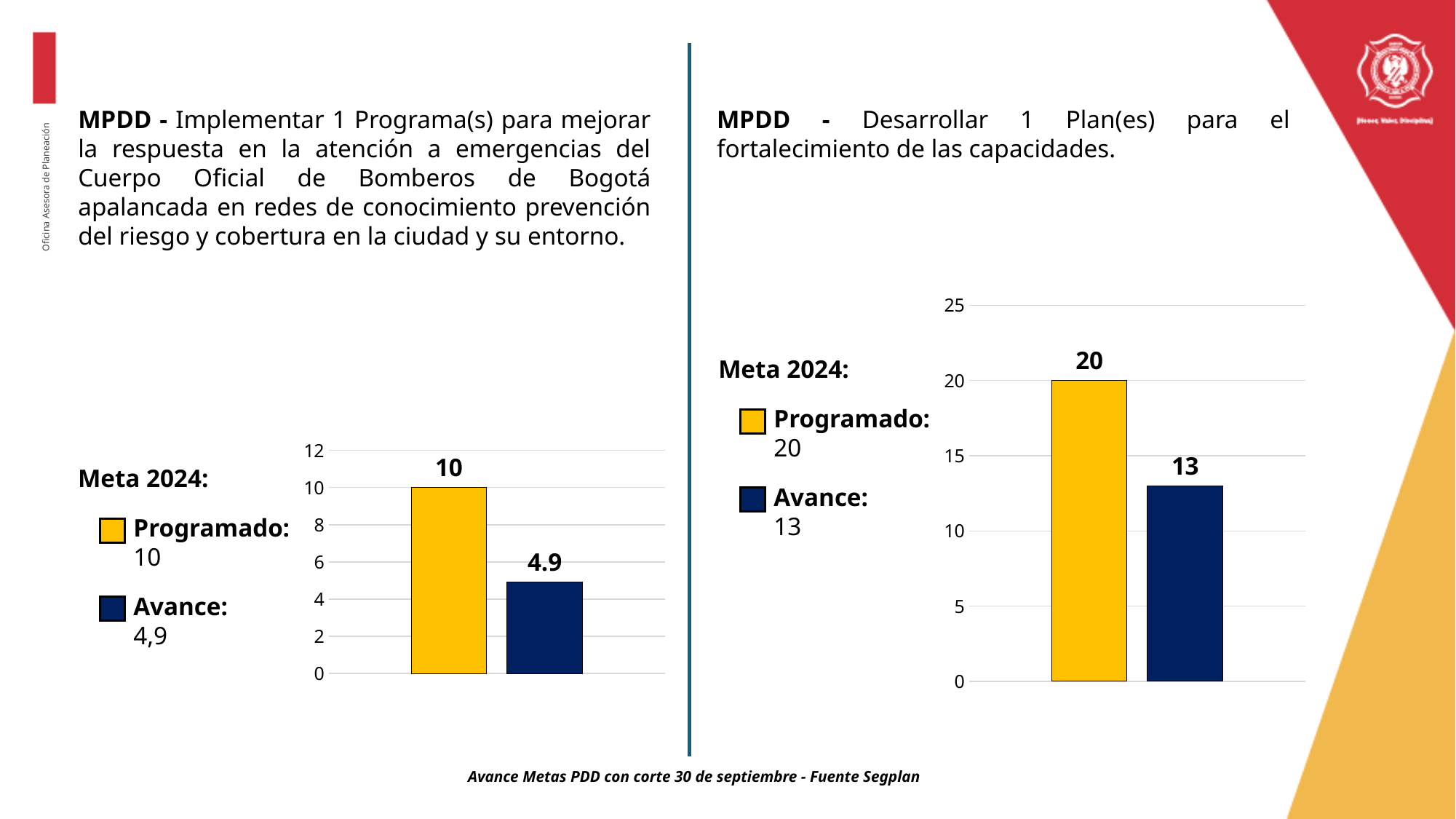
In the right chart, what is the difference between the Programado and Avance values? 7 In the left chart, what is the difference between the Programado and Avance values? 5.1 In the left chart, what colour is the Programado bar? yellow In the left chart, which bar is higher, Programado or Avance? Programado In the right chart, what is the value of the Avance bar? 13 In the right chart, which bar is the lowest? Avance What kind of chart is the right chart? bar chart In the right chart, what is the value of the Programado bar? 20 How many bars are plotted in the left chart? 2 In the left chart, what is the value of the Programado bar? 10 In the left chart, what is the value of the Avance bar? 4.9 In the right chart, is the value for Avance greater or less than 15? less